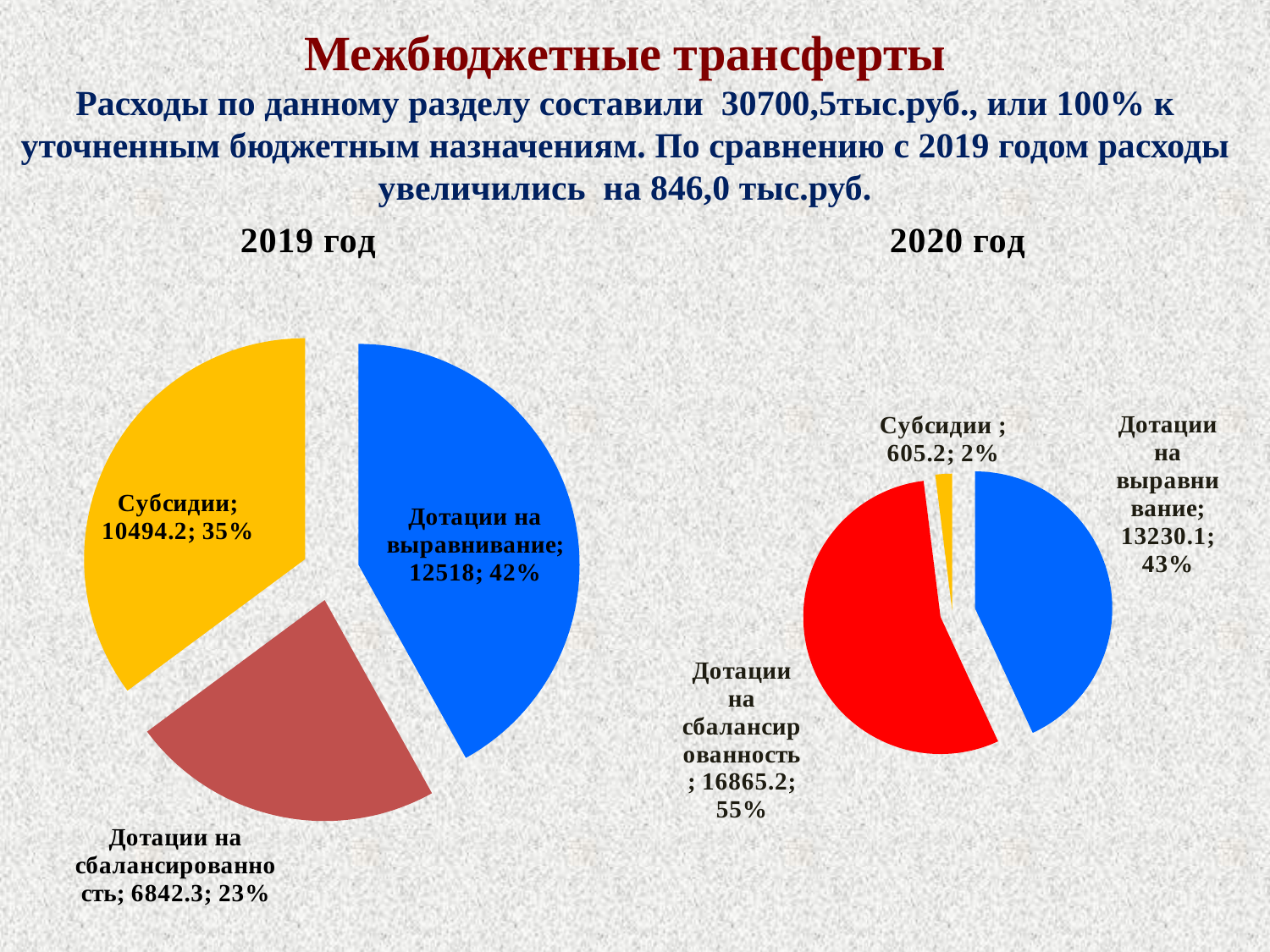
In the 2020 год pie chart, which is larger: Дотации на выравнивание or Субсидии? Дотации на выравнивание In the 2019 год pie chart, what is the value for Субсидии? 10494.2 In the 2019 год pie chart, what colour is the Субсидии slice? Yellow How many slices does the 2019 год pie chart have? 3 What type of chart is used for 2020 год? Pie chart In the 2020 год pie chart, which category has the largest slice? Дотации на сбалансированность In the 2020 год pie chart, what is the difference between the values for Дотации на сбалансированность and Дотации на выравнивание? 3635.1 In the 2019 год pie chart, what share does Дотации на выравнивание have? 42% In the 2019 год pie chart, what is the difference between the values for Дотации на выравнивание and Субсидии? 2023.8 In the 2020 год pie chart, what is the value for Дотации на сбалансированность? 16865.2 In the 2020 год pie chart, what share does Субсидии have? 2% In the 2019 год pie chart, which category has the smallest slice? Дотации на сбалансированность